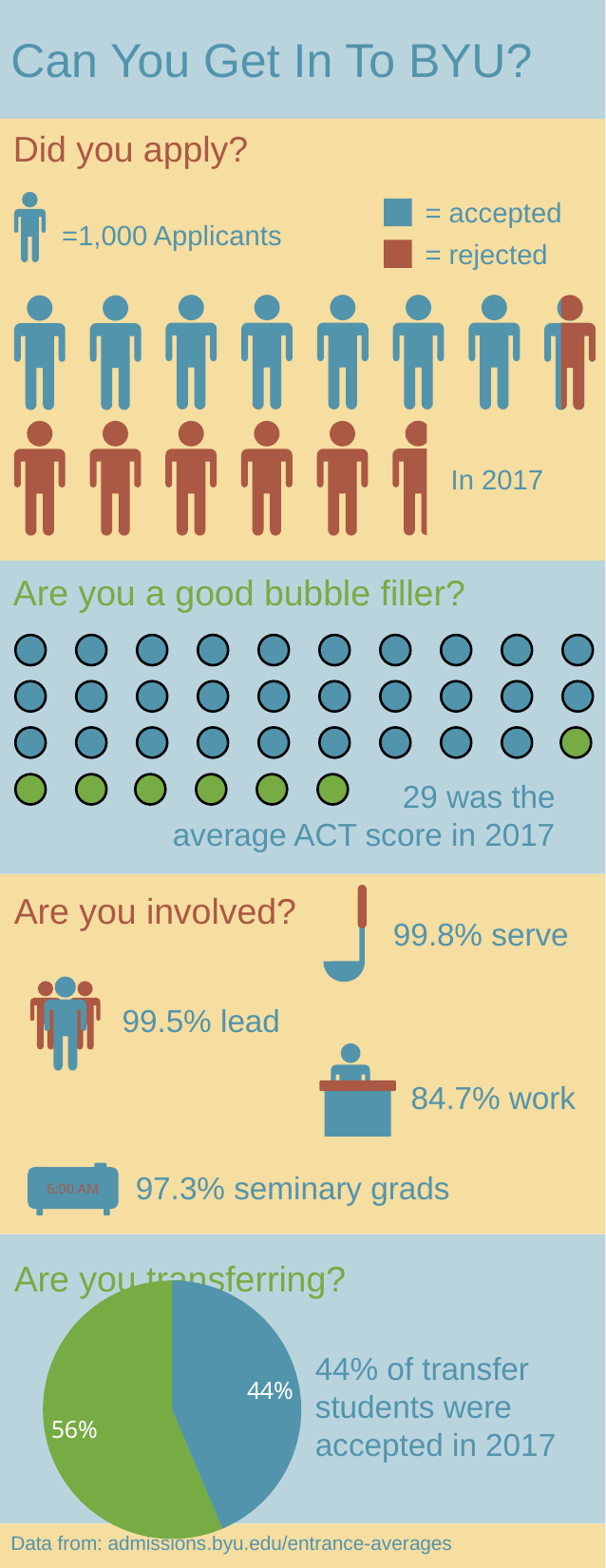
What kind of chart is shown in the 'Are you transferring?' section? pie chart In the 'Are you involved?' section, which activity has the highest percentage? serve (99.8%) In the 'Are you transferring?' pie chart, what is the difference between the green slice and the blue slice? 12% In the 'Are you involved?' section, what percentage of students work? 84.7% In the 'Did you apply?' pictograph, how many applicants does one person icon represent? 1,000 Applicants In the 'Are you transferring?' pie chart, which slice is larger, the blue 44% slice or the green 56% slice? the green 56% slice In the 'Did you apply?' pictograph, what does the blue colour represent? accepted In the 'Are you a good bubble filler?' section, what was the average ACT score in 2017? 29 In the 'Are you transferring?' pie chart, what percentage of transfer students were accepted in 2017? 44% In the 'Are you transferring?' pie chart, what percentage does the green slice represent? 56% In the 'Did you apply?' pictograph, how many categories does the legend list? 2 In the 'Are you involved?' section, what is the difference between the percentage who serve and the percentage who work? 15.1%